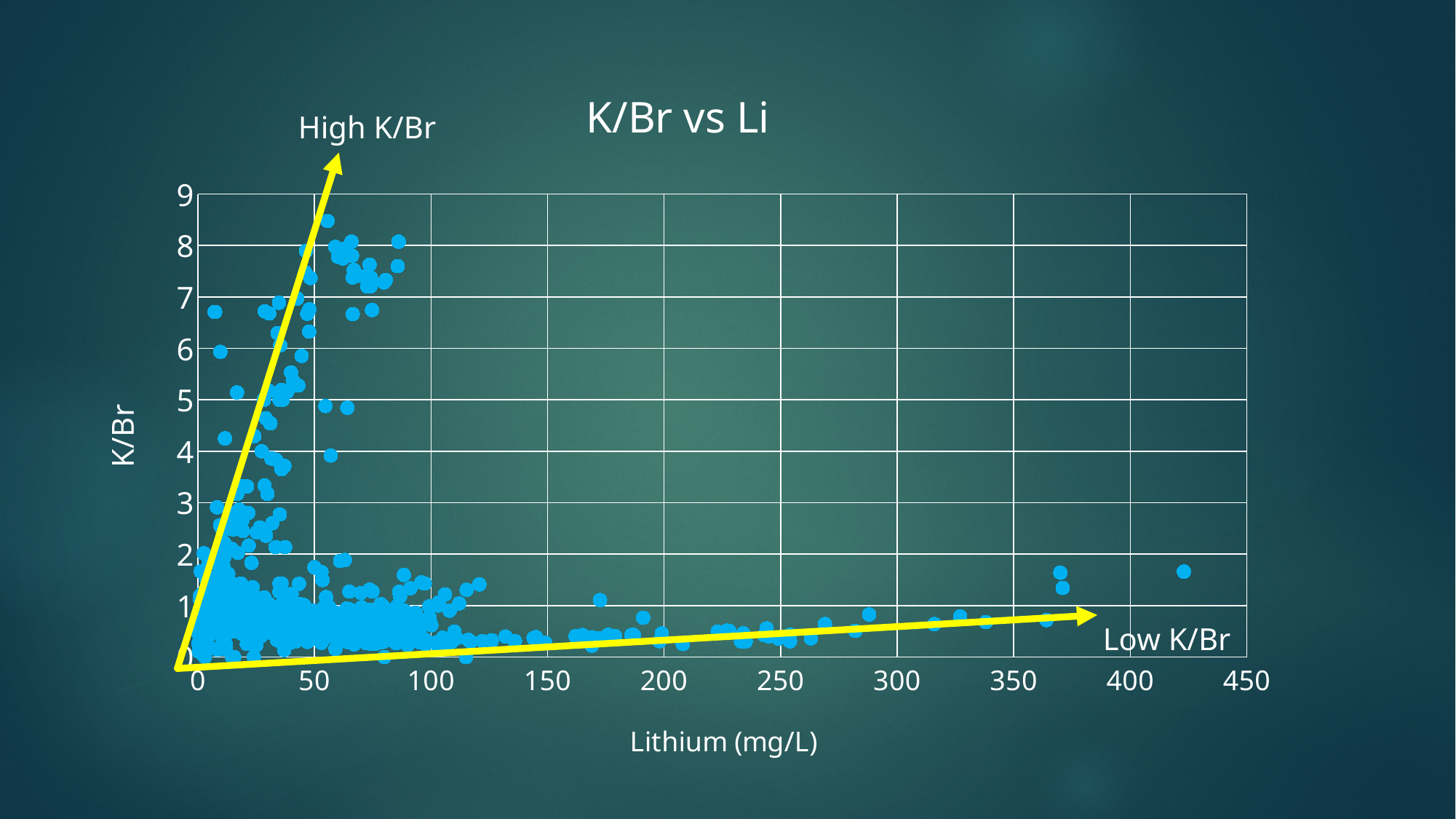
What is the highest value shown on the x axis (Lithium) of the chart? 450 Is the K/Br value of the point plotted near 175 mg/L lithium greater or less than 2? less What is the highest value shown on the y axis (K/Br) of the chart? 9 What kind of chart is shown on the slide? scatter plot What is the title of the chart? K/Br vs Li Is the highest K/Br value plotted on the chart greater or less than 8? greater Is the lithium value of the rightmost point on the chart greater or less than 400? greater What is the interval between consecutive tick marks on the x axis of the chart? 50 What labels do the two yellow arrows on the chart carry? High K/Br and Low K/Br How many data series are plotted on the chart? 1